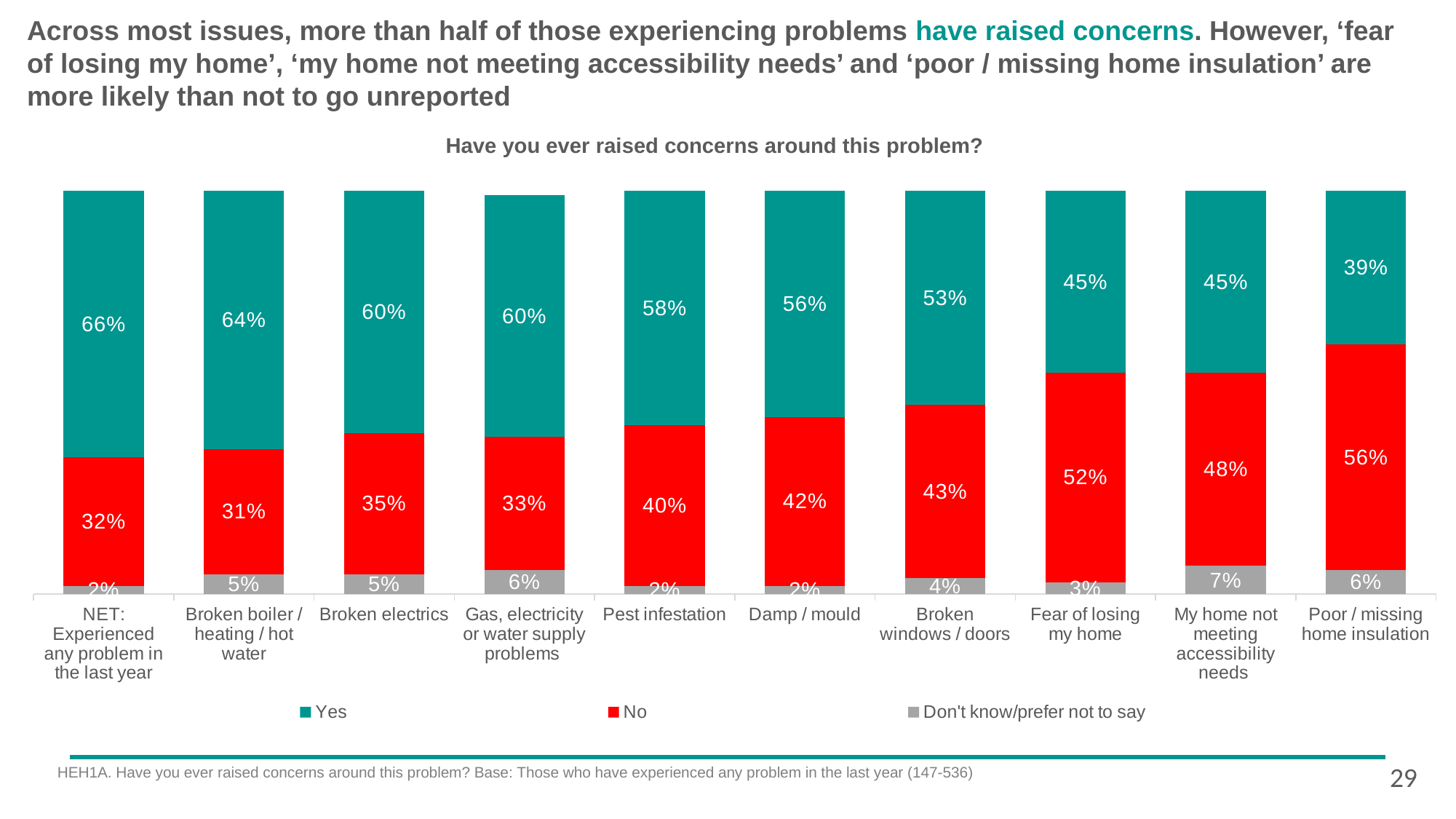
How many problem categories are shown on the x axis? 10 Which has a larger 'No' percentage: 'Pest infestation' or 'Broken electrics'? Pest infestation How many series does the legend list? 3 What percentage of respondents with poor / missing home insulation answered 'No'? 56% What is the 'Don't know/prefer not to say' value for 'My home not meeting accessibility needs'? 7% Which category has the highest 'Yes' percentage? NET: Experienced any problem in the last year What percentage of respondents who experienced damp / mould answered 'Yes' to having raised concerns? 56% What colour represents the 'No' series in the chart? Red Do the 'Yes' percentages generally rise or fall moving from left to right along the x axis? Fall Which category has the lowest 'Yes' percentage? Poor / missing home insulation What is the difference between the 'No' percentages for 'Fear of losing my home' and 'Broken boiler / heating / hot water'? 21 percentage points What kind of chart is shown on the slide? Stacked bar chart